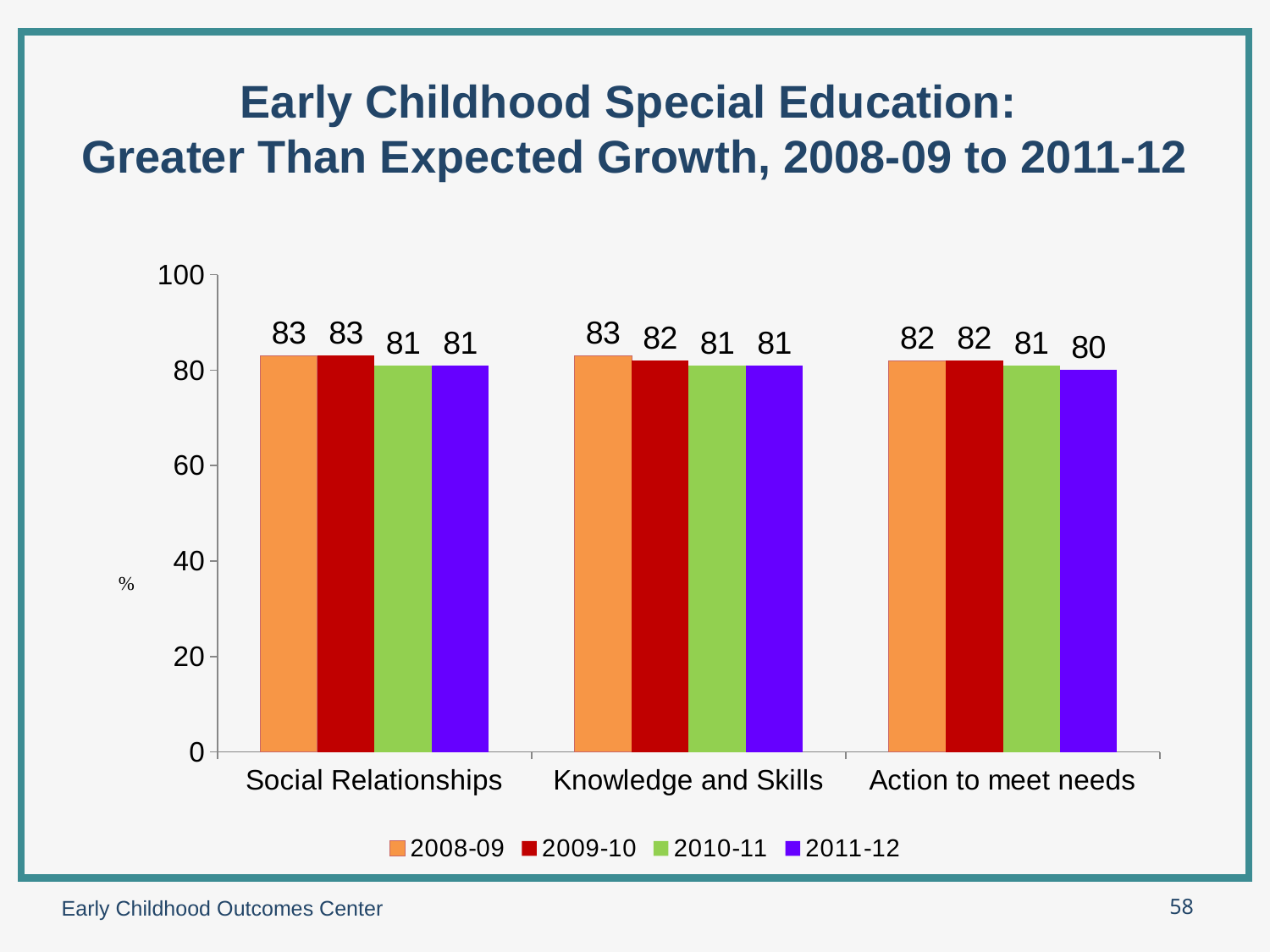
What label is shown on the y axis? % How many series does the legend list? 4 How many categories are shown on the x axis? 3 What kind of chart is shown on the slide? Bar chart What is the value for 2008-09 in the Social Relationships category? 83 Do the values for Action to meet needs rise or fall from 2008-09 to 2011-12? Fall What is the difference between the 2008-09 and 2011-12 values for Action to meet needs? 2 What is the value for 2010-11 in the Action to meet needs category? 81 What is the value for 2011-12 in the Action to meet needs category? 80 What is the difference between the 2008-09 and 2010-11 values for Social Relationships? 2 Which year has the lowest value in the Action to meet needs category? 2011-12 What is the value for 2009-10 in the Knowledge and Skills category? 82